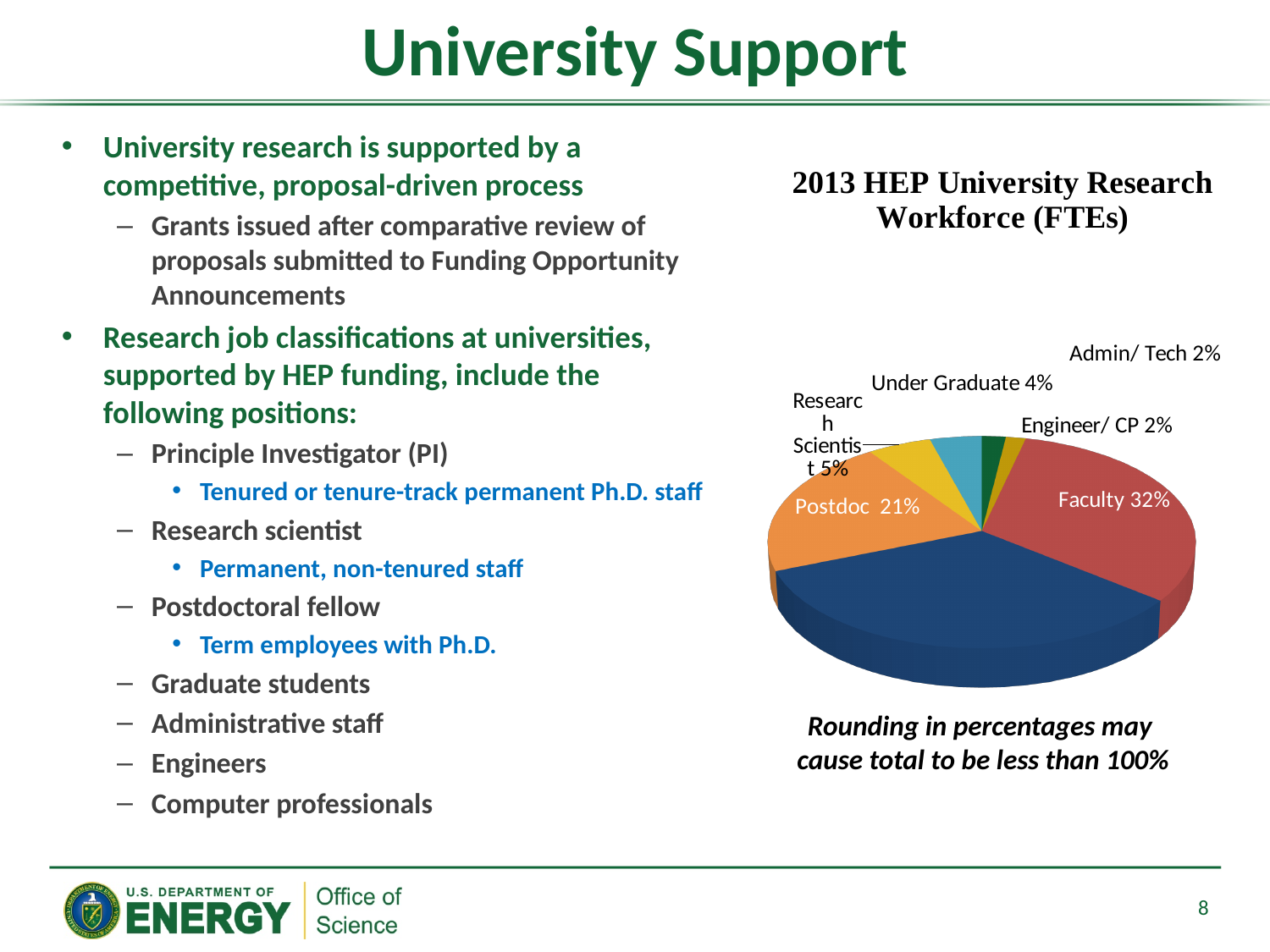
What percentage of the 2013 HEP University Research Workforce is Faculty? 32% According to the note below the chart, what may cause the total to be less than 100%? Rounding in percentages How many percentage points larger is the Faculty share than the Postdoc share? 11% What percentage does the Research Scientist slice represent? 5% What percentage is shown for Under Graduate in the pie chart? 4% Which is larger, the Postdoc share or the Research Scientist share? Postdoc What percentage is shown for Admin/ Tech? 2% Which is larger, the Under Graduate share or the Faculty share? Faculty What share of the pie chart is labeled Postdoc? 21% What percentage is shown for Engineer/ CP? 2% What is the title of the chart on the slide? 2013 HEP University Research Workforce (FTEs) What kind of chart is shown on the slide? Pie chart